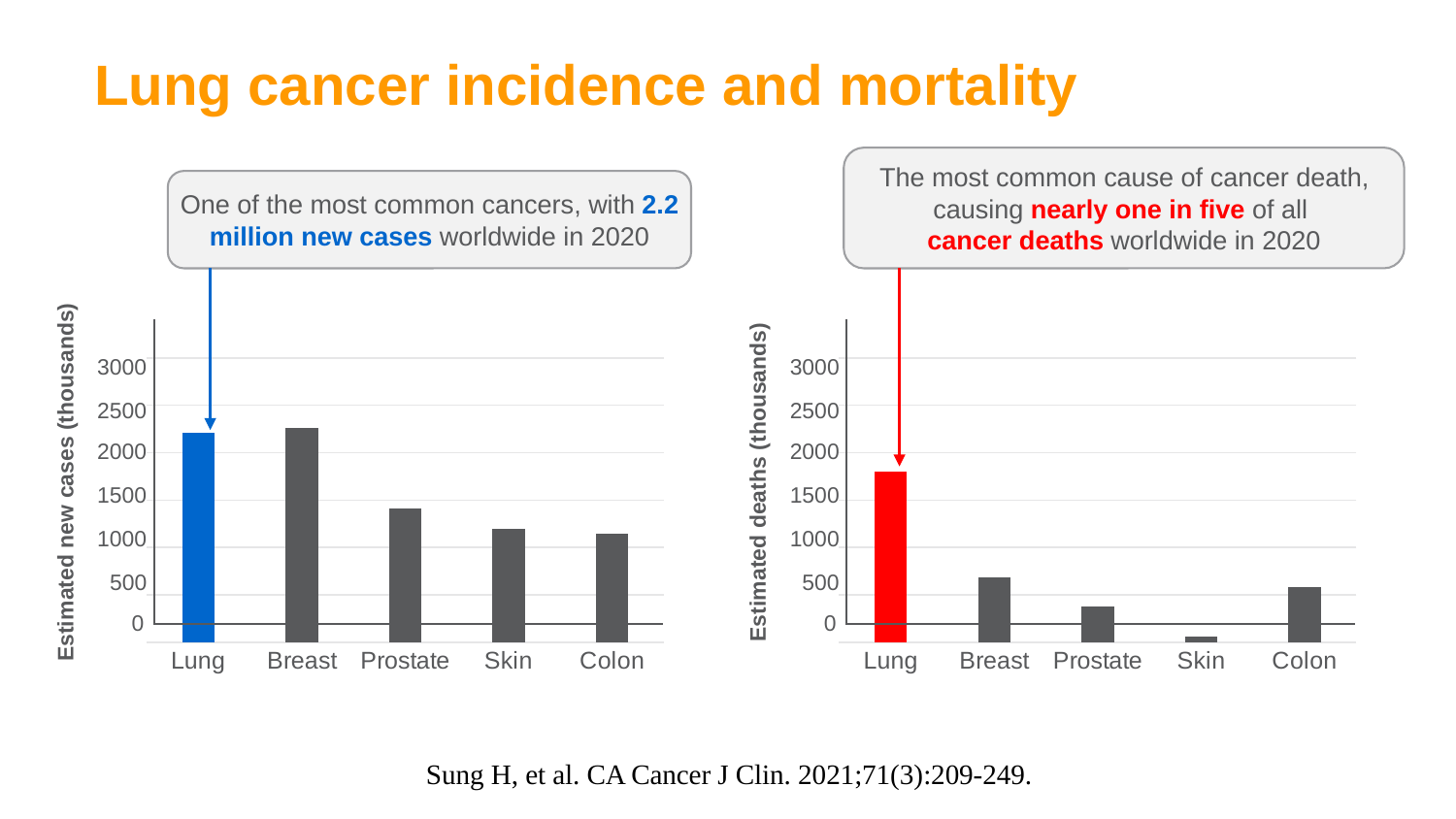
What kind of chart is the left chart (Estimated new cases)? Bar chart On the right chart (Estimated deaths), is the value for Breast greater or less than 1000? less On the left chart (Estimated new cases), what colour is the Lung bar? Blue On the left chart (Estimated new cases), is the value for Prostate greater or less than 1500? less What is the y-axis label of the right chart? Estimated deaths (thousands) On the left chart (Estimated new cases), is the value for Lung greater or less than 2000? greater On the left chart (Estimated new cases), which is larger, the value for Lung or the value for Prostate? Lung On the right chart (Estimated deaths), which is larger, the value for Breast or the value for Colon? Breast On the right chart (Estimated deaths), which cancer type has the highest value? Lung How many cancer types are shown on the right chart (Estimated deaths)? 5 On the right chart (Estimated deaths), which cancer type has the lowest value? Skin